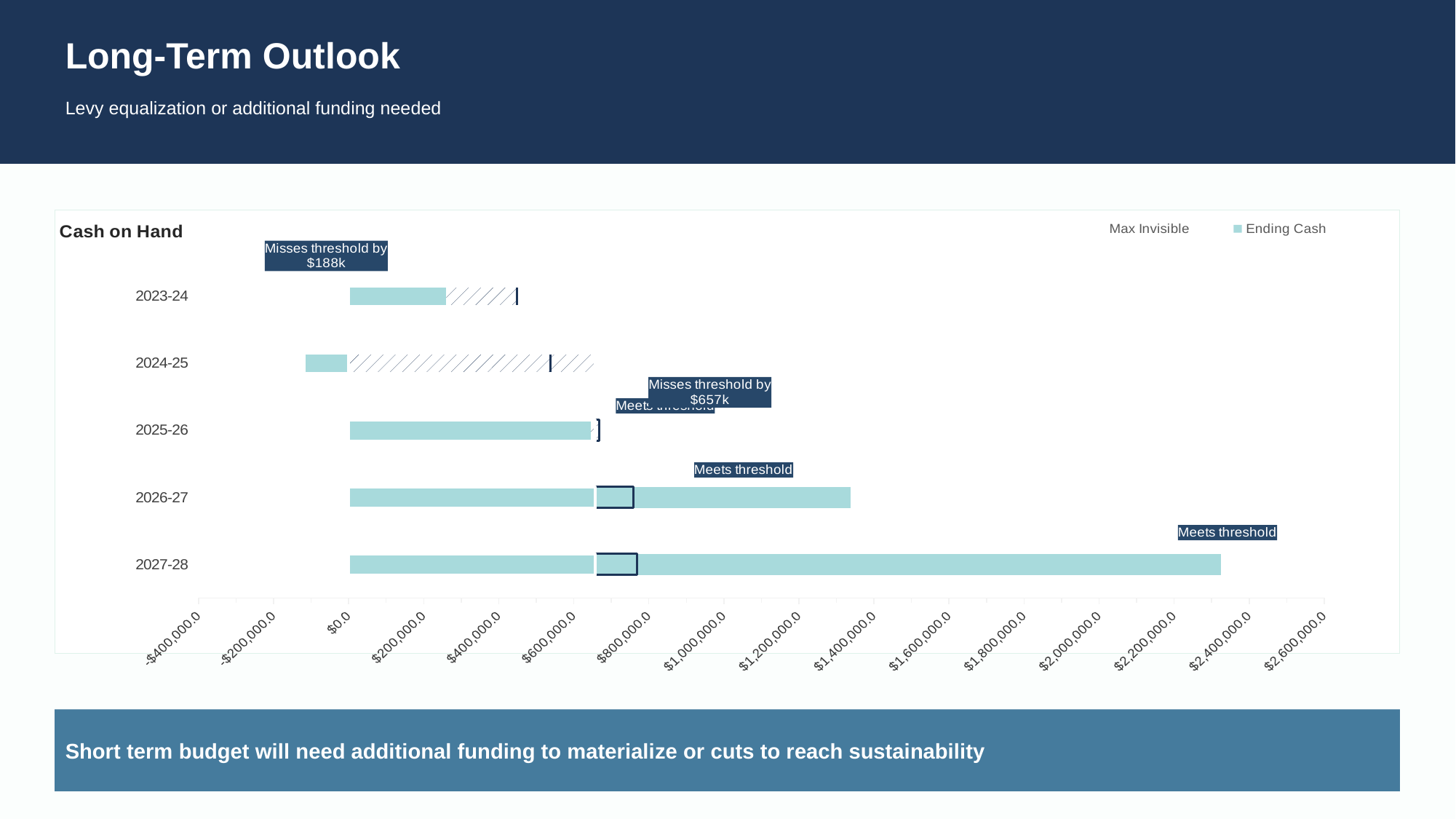
Which fiscal year has the highest Ending Cash on the Cash on Hand chart? 2027-28 Which has the larger Ending Cash, 2023-24 or 2026-27? 2026-27 Which fiscal year has the lowest Ending Cash on the Cash on Hand chart? 2024-25 How many fiscal years are shown on the Cash on Hand chart? 5 By how much does 2023-24 miss the threshold according to its label on the Cash on Hand chart? $188k How many series does the legend of the Cash on Hand chart list? 2 Is the Ending Cash value for 2026-27 greater or less than $1,000,000.0? greater What is the title of the chart on the slide? Cash on Hand By how much does 2024-25 miss the threshold according to its label on the Cash on Hand chart? $657k Is the Ending Cash value for 2027-28 greater or less than $2,000,000.0? greater Is the Ending Cash value for 2024-25 greater or less than $0.0? less What kind of chart is the Cash on Hand chart? bar chart